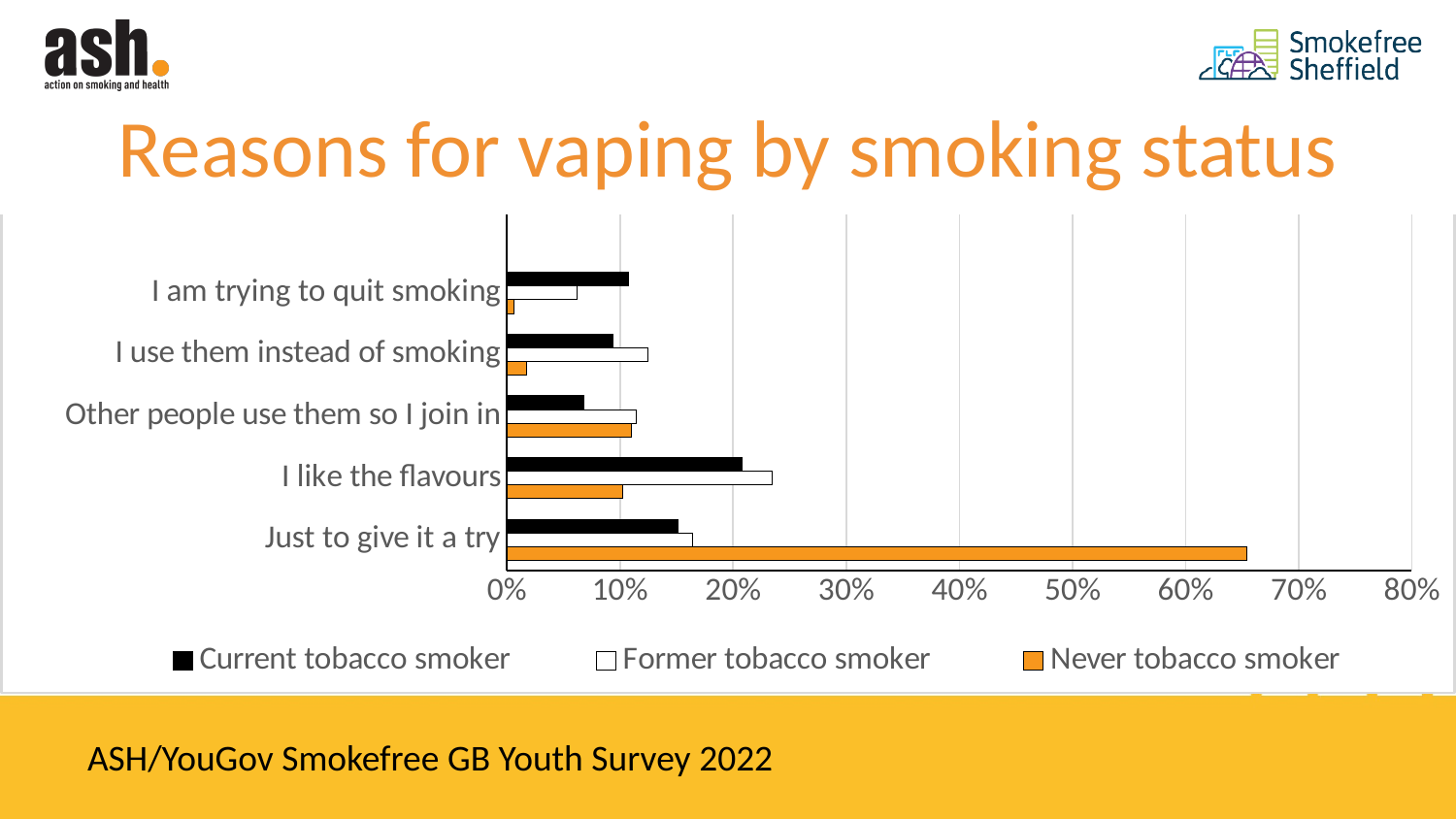
For 'I am trying to quit smoking', which is larger: the Current tobacco smoker value or the Never tobacco smoker value? Current tobacco smoker How many reasons for vaping are listed on the y axis? 5 What colour represents Never tobacco smoker in the legend? Orange For 'Just to give it a try', which is larger: the Never tobacco smoker value or the Current tobacco smoker value? Never tobacco smoker How many series does the legend list? 3 For Current tobacco smokers, which reason has the highest value? I like the flavours Is the value for Never tobacco smoker for 'Just to give it a try' greater or less than 60%? greater Is the value for Former tobacco smoker for 'I use them instead of smoking' greater or less than 10%? greater Is the value for Current tobacco smoker for 'I like the flavours' greater or less than 30%? less For Never tobacco smokers, which reason has the highest value? Just to give it a try What kind of chart is shown on the slide? Bar chart